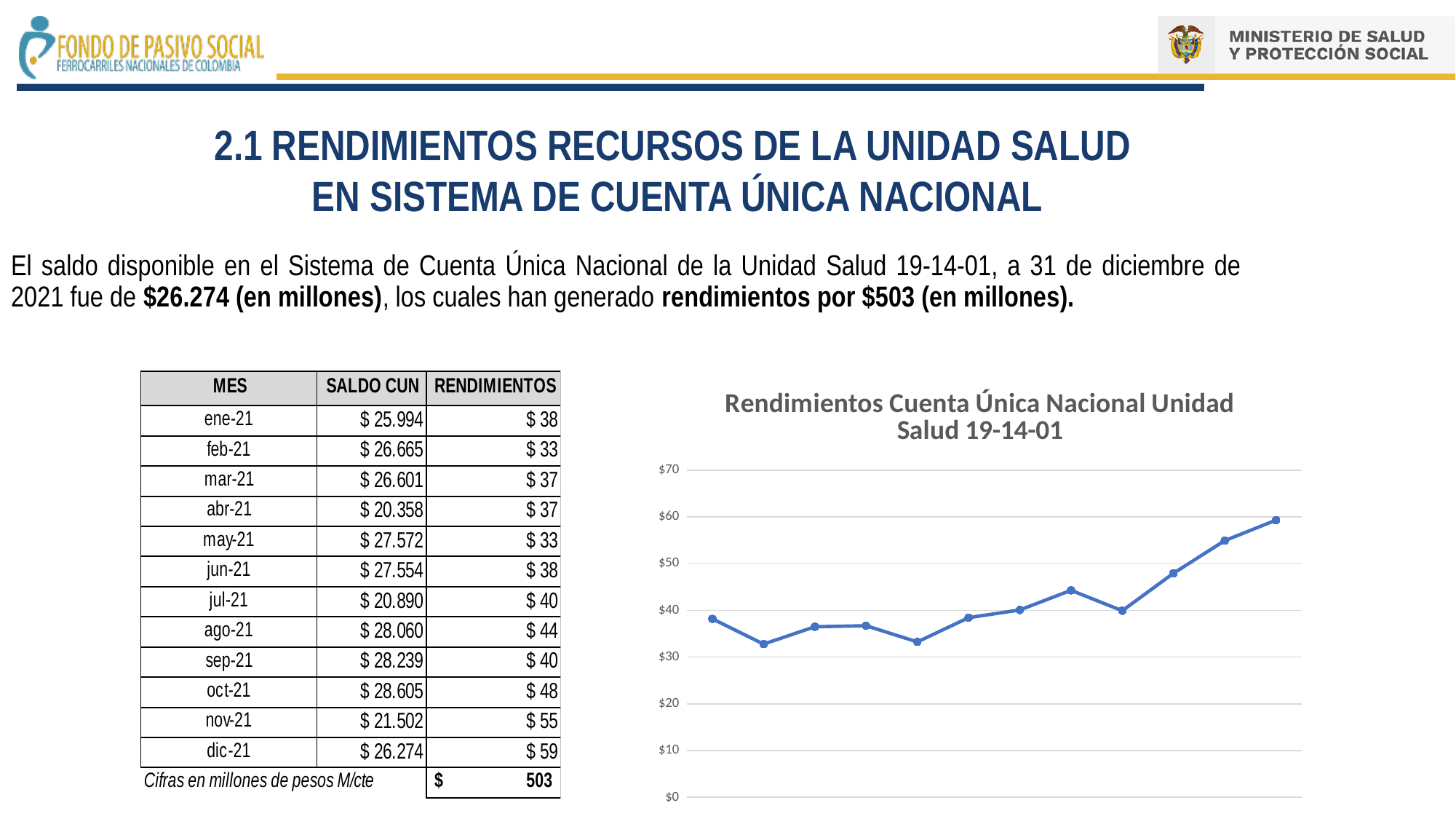
Does the line on the chart overall rise or fall from the first point to the last point? rise What is the highest value shown on the chart's vertical axis? $70 Is the value of the second point on the chart greater or less than $40? less How many data points are plotted on the line in the chart? 12 Which point on the chart has the highest value, the first or the last? the last What is the title of the chart? Rendimientos Cuenta Única Nacional Unidad Salud 19-14-01 Is the value of the last (rightmost) point on the chart greater or less than $50? greater Is the value of the first (leftmost) point on the chart greater or less than $50? less What kind of chart is shown on the slide? line chart